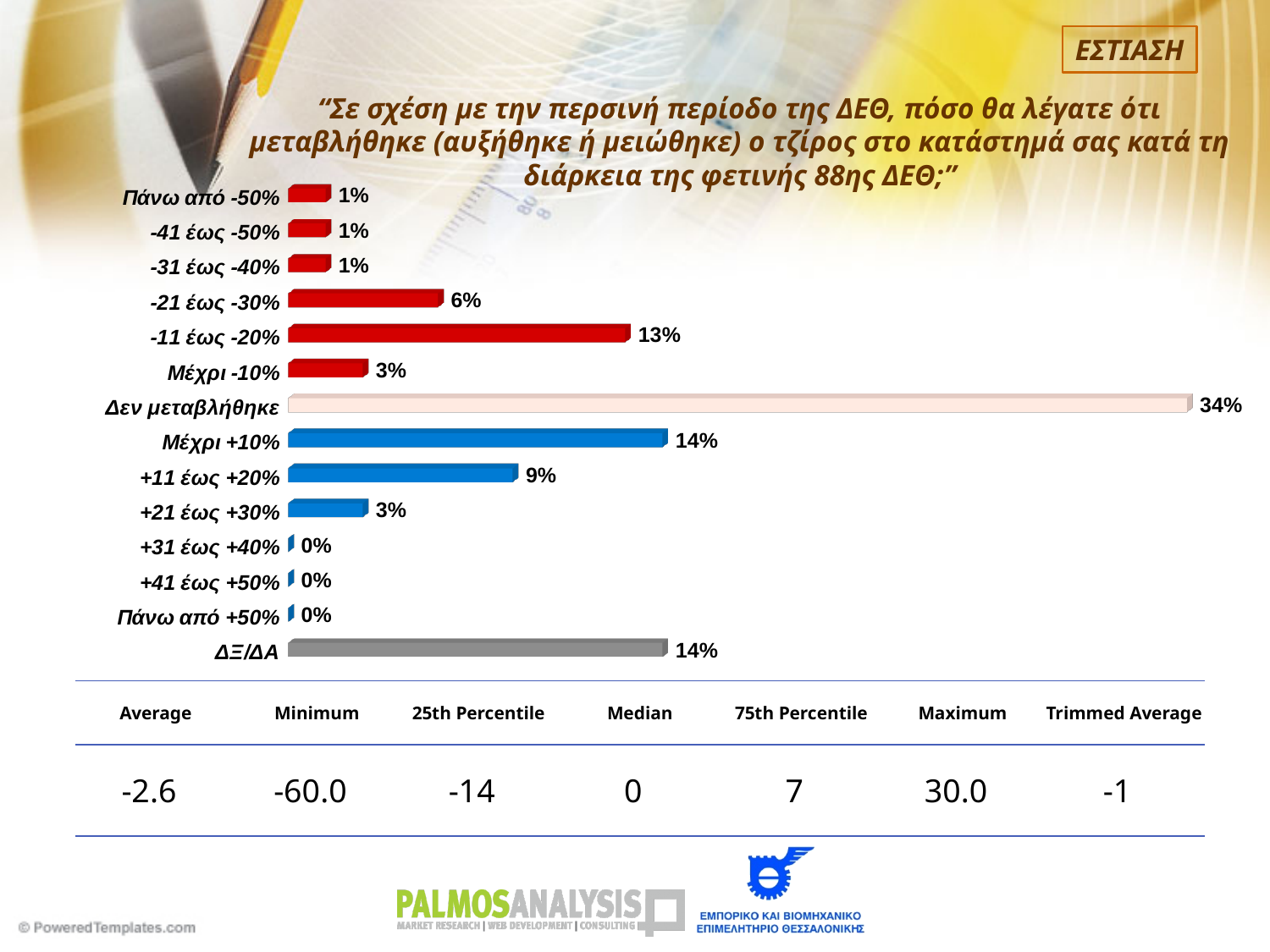
What is the value for "ΔΞ/ΔΑ"? 14% What kind of chart is shown on the slide? bar chart What is the value for "-11 έως -20%"? 13% What is the value for "+11 έως +20%"? 9% What is the difference between the values for "-21 έως -30%" and "Μέχρι -10%"? 3 percentage points How many categories does the bar chart show? 14 Which category has the highest value? Δεν μεταβλήθηκε Which is larger, the value for "-11 έως -20%" or the value for "+11 έως +20%"? -11 έως -20% What is the value for "Δεν μεταβλήθηκε"? 34% What is the difference between the values for "Δεν μεταβλήθηκε" and "Μέχρι +10%"? 20 percentage points What is the value for "Μέχρι +10%"? 14% How many categories have a value of 0%? 3